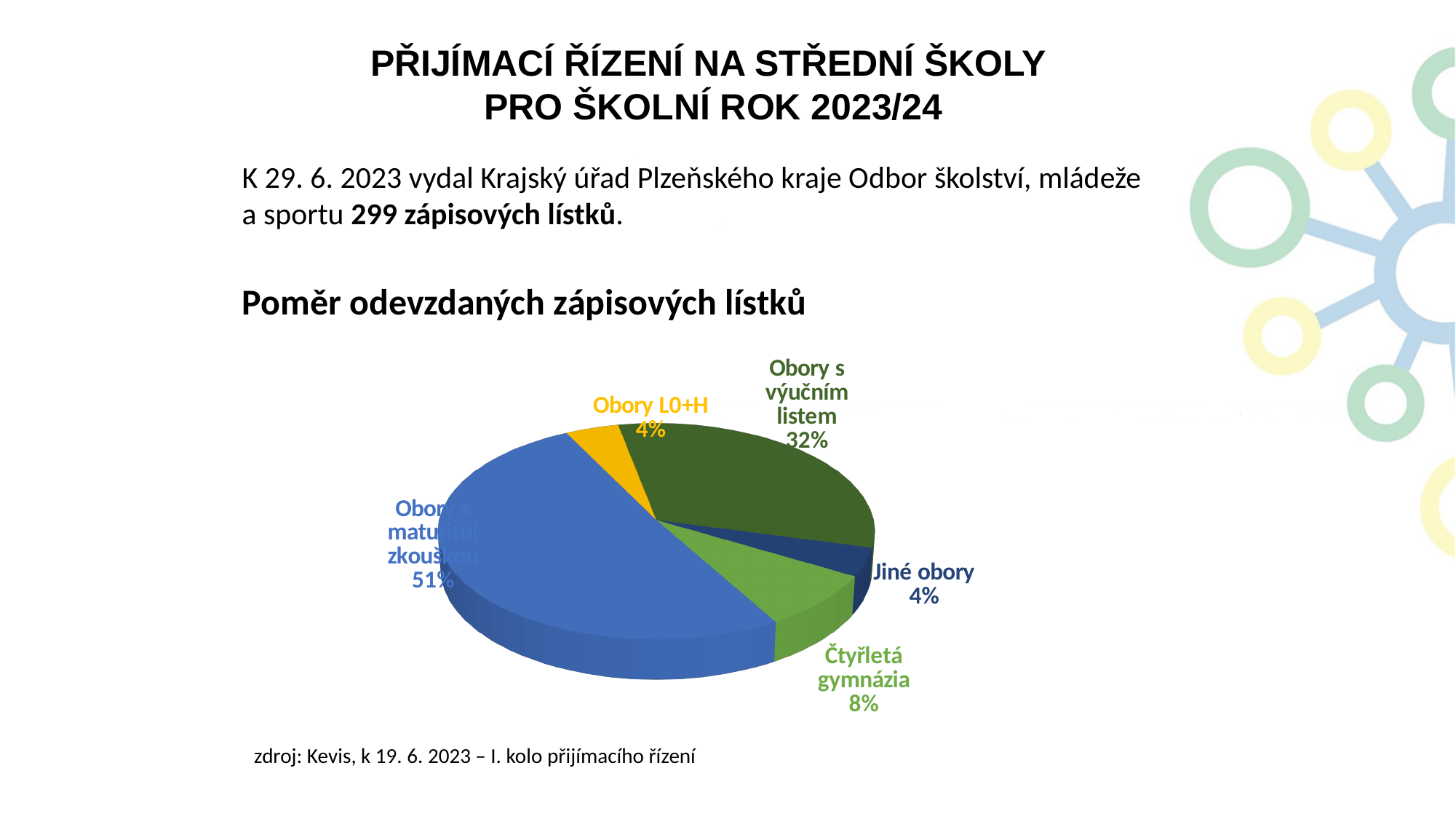
What share of the pie does "Obory s maturitní zkouškou" have? 51% What share of the pie does "Obory s výučním listem" have? 32% Which category has the largest slice of the pie? Obory s maturitní zkouškou What is the value shown for "Obory L0+H"? 4% What is the difference between the shares of "Obory s maturitní zkouškou" and "Obory s výučním listem"? 19% What kind of chart is shown on the slide? pie chart What is the difference between the shares of "Čtyřletá gymnázia" and "Jiné obory"? 4% What is the value shown for "Jiné obory"? 4% What is the value shown for "Čtyřletá gymnázia"? 8% Which is larger, the share for "Obory s výučním listem" or for "Čtyřletá gymnázia"? Obory s výučním listem What is the title of the pie chart? Poměr odevzdaných zápisových lístků How many slices does the pie chart have? 5